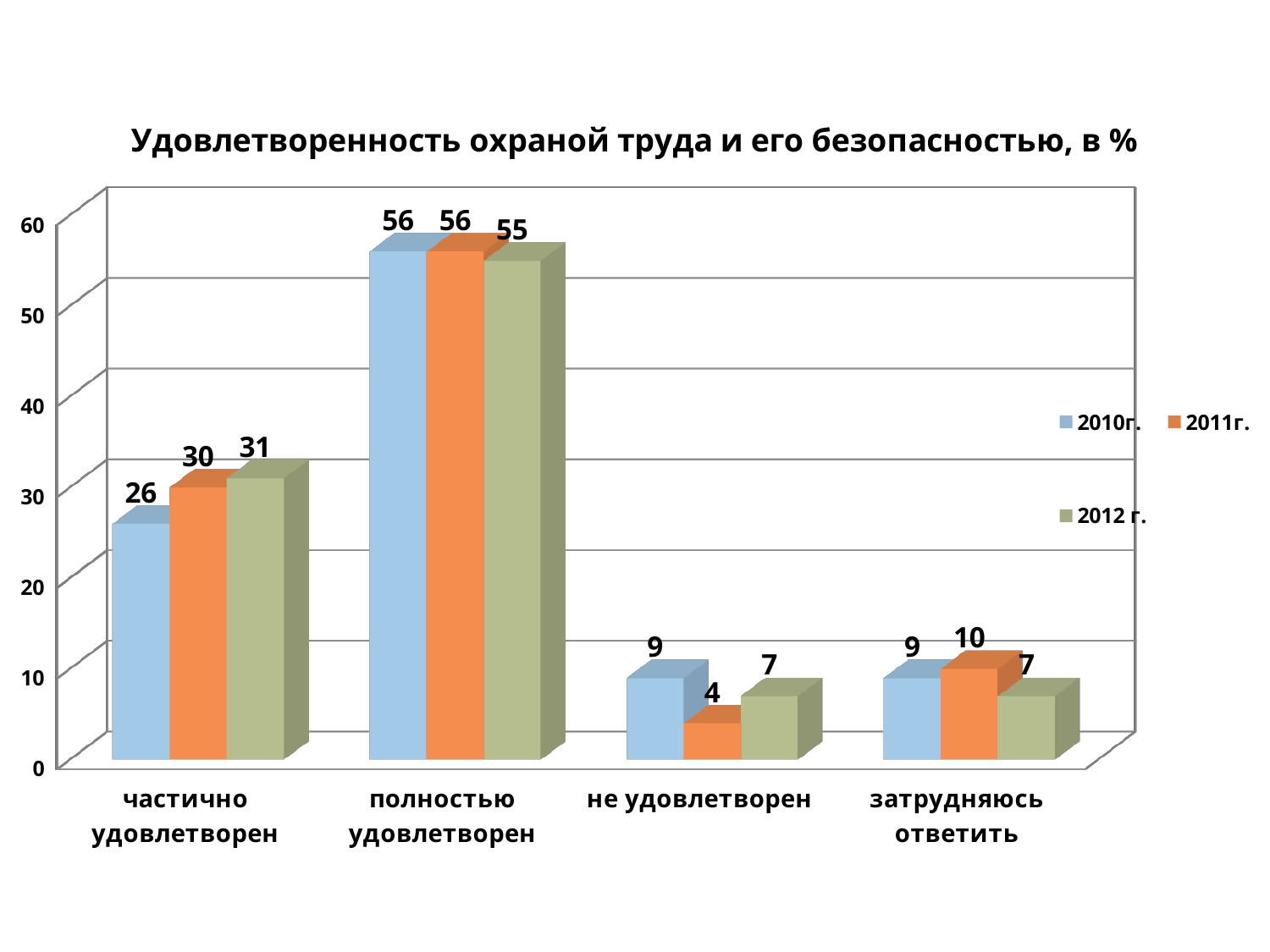
What is the title of the chart? Удовлетворенность охраной труда и его безопасностью, в % What is the value for 2012 г. in the 'полностью удовлетворен' category? 55 What is the difference between the 2012 г. and 2010г. values in the 'частично удовлетворен' category? 5 Which is larger in the 'не удовлетворен' category: the 2010г. value or the 2012 г. value? 2010г. Which category has the highest value for 2010г.? полностью удовлетворен What is the value for 2011г. in the 'не удовлетворен' category? 4 How many categories are shown on the x axis? 4 What kind of chart is shown on the slide? bar chart Which category has the lowest value for 2011г.? не удовлетворен What is the value for 2011г. in the 'затрудняюсь ответить' category? 10 What is the value for 2010г. in the 'частично удовлетворен' category? 26 How many series does the legend list? 3